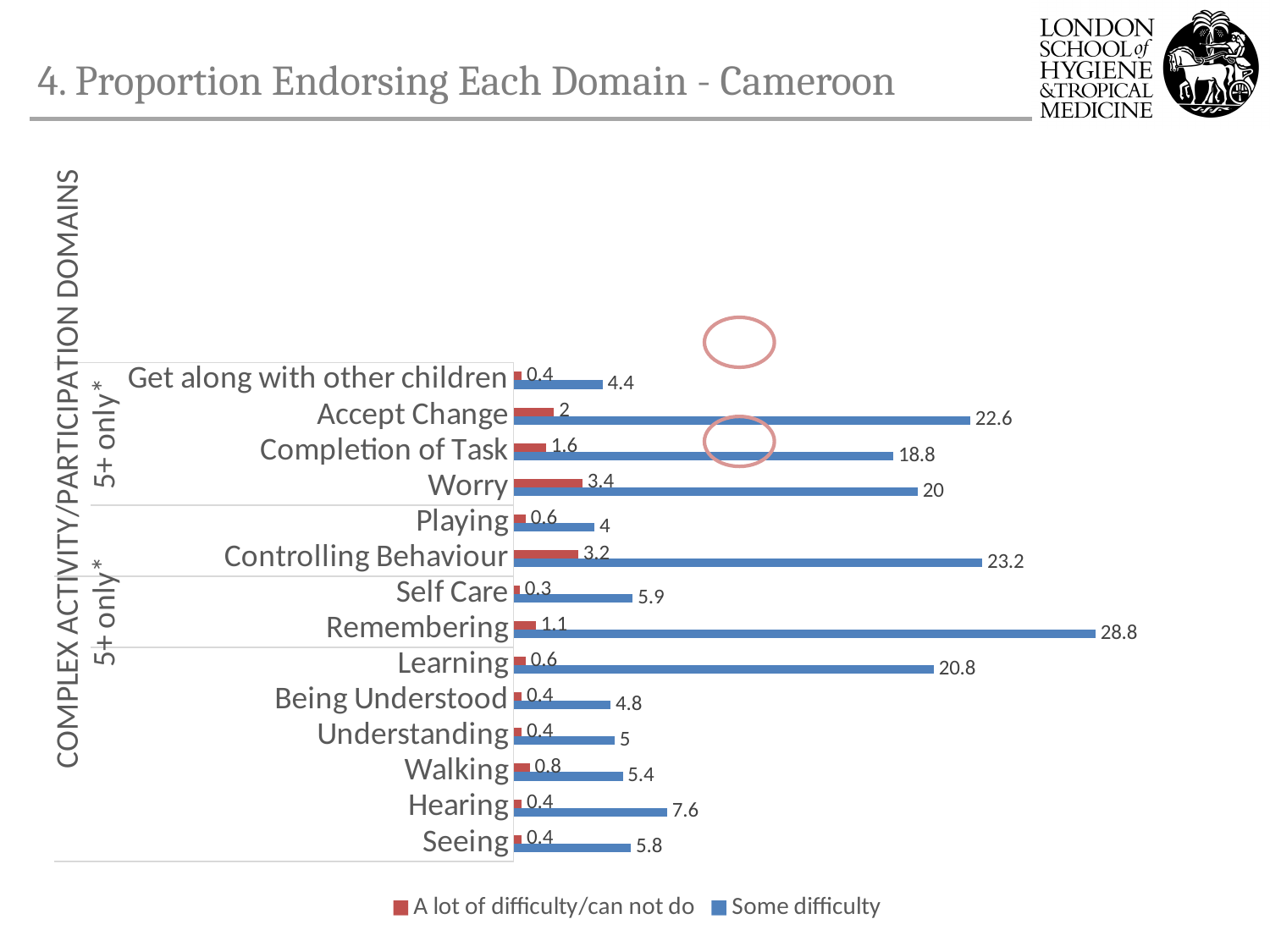
What type of chart is shown on the slide? Bar chart What is the difference between the 'Some difficulty' values for Remembering and Learning? 8 How many series does the legend list? 2 What is the 'Some difficulty' value for Remembering? 28.8 What is the 'A lot of difficulty/can not do' value for Worry? 3.4 Which colour represents 'Some difficulty' in the chart? Blue Which domain has the highest 'Some difficulty' value? Remembering Which domain has the highest 'A lot of difficulty/can not do' value? Worry Which has a larger 'Some difficulty' value, Hearing or Seeing? Hearing What is the 'Some difficulty' value for Accept Change? 22.6 Which domain has the lowest 'Some difficulty' value? Playing How many domains are shown in the chart? 14